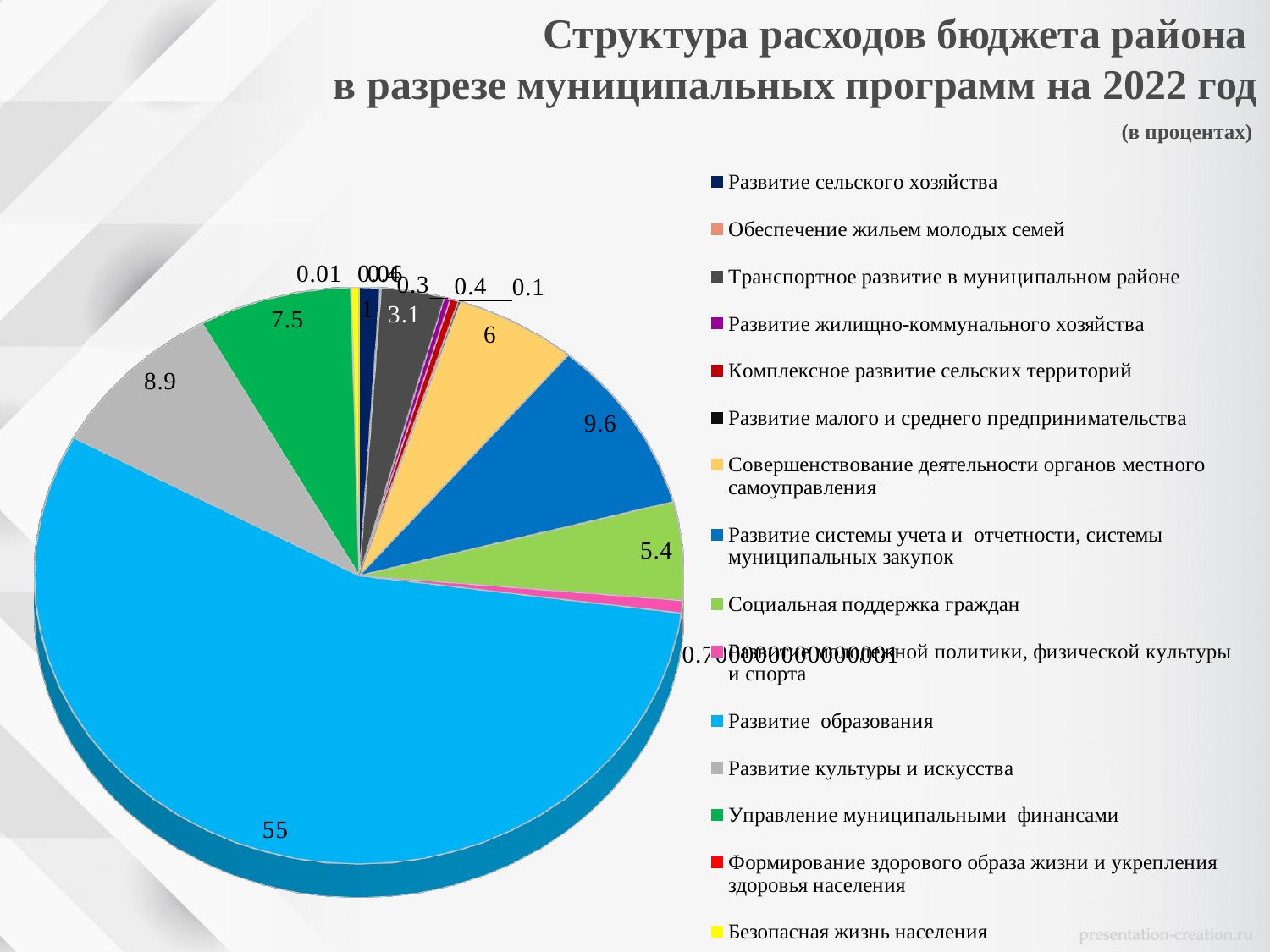
What is the value for Развитие культуры и искусства? 8.9 What is the value for Транспортное развитие в муниципальном районе? 3.1 What unit is stated under the chart title? в процентах What is the value for Развитие системы учета и отчетности, системы муниципальных закупок? 9.6 What is the value for Развитие образования? 55 What kind of chart is shown on the slide? Pie chart What is the difference between the values for Развитие образования and Развитие культуры и искусства? 46.1 Which program has the largest share of the pie? Развитие образования Which is larger: Развитие системы учета и отчетности, системы муниципальных закупок or Совершенствование деятельности органов местного самоуправления? Развитие системы учета и отчетности, системы муниципальных закупок What is the value for Социальная поддержка граждан? 5.4 What is the value for Управление муниципальными финансами? 7.5 How many entries does the legend list? 15